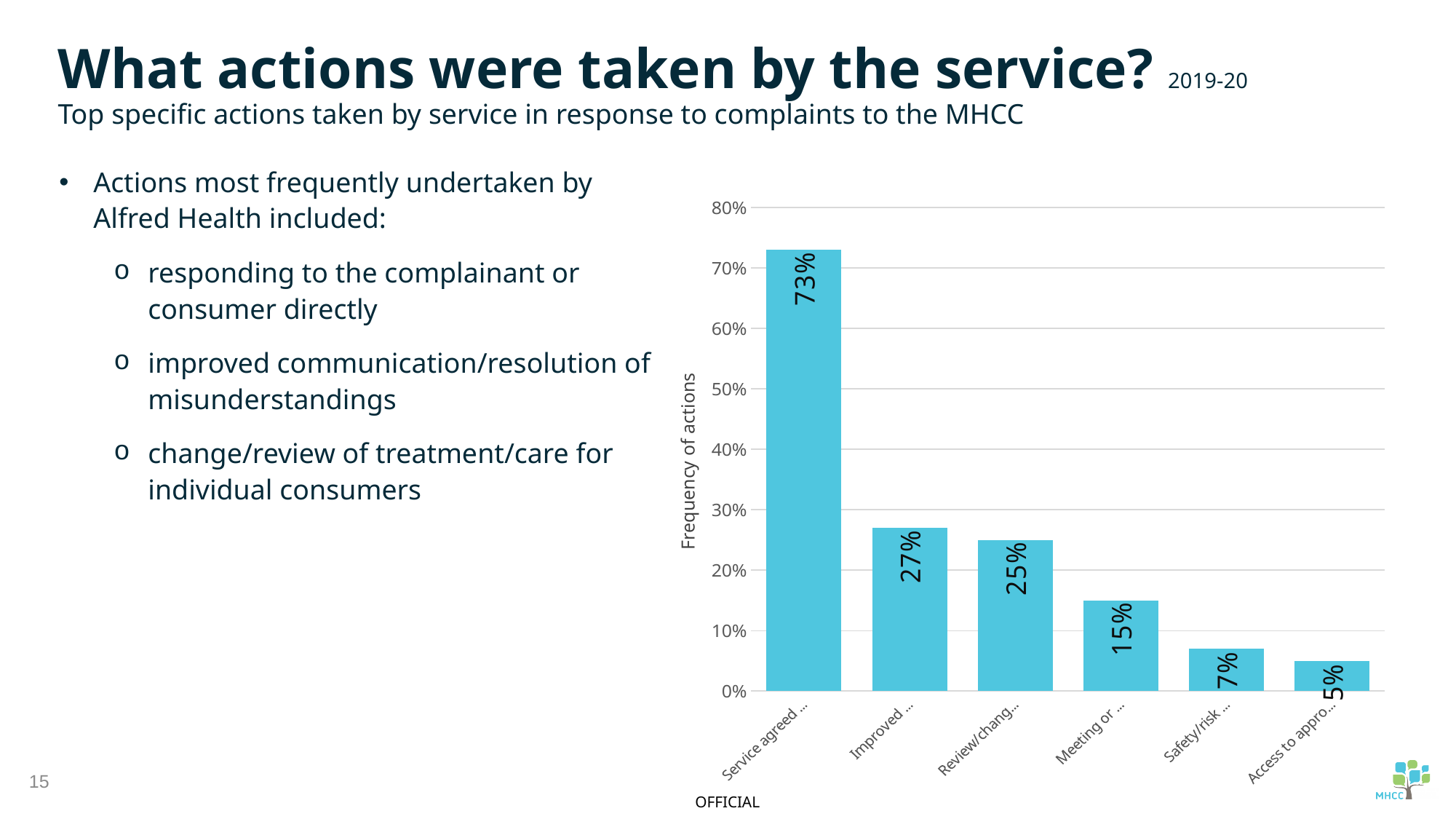
What is the label of the vertical axis? Frequency of actions Which bar has the highest value? Service agreed ... (the first bar) Which is larger, the value for "Improved ..." or the value for "Review/chang..."? Improved ... What is the value of the bar labelled "Meeting or ..."? 15% What type of chart is shown on the slide? bar chart What is the difference between the first bar (73%) and the second bar (27%)? 46% What is the value of the first (tallest) bar, labelled "Service agreed ..."? 73% Which bar has the lowest value? Access to appro... (the last bar) Do the bar values rise or fall from left to right along the x axis? fall What is the value of the bar labelled "Safety/risk ..."? 7% How many bars (categories) does the chart show? 6 What is the value of the last bar, labelled "Access to appro..."? 5%